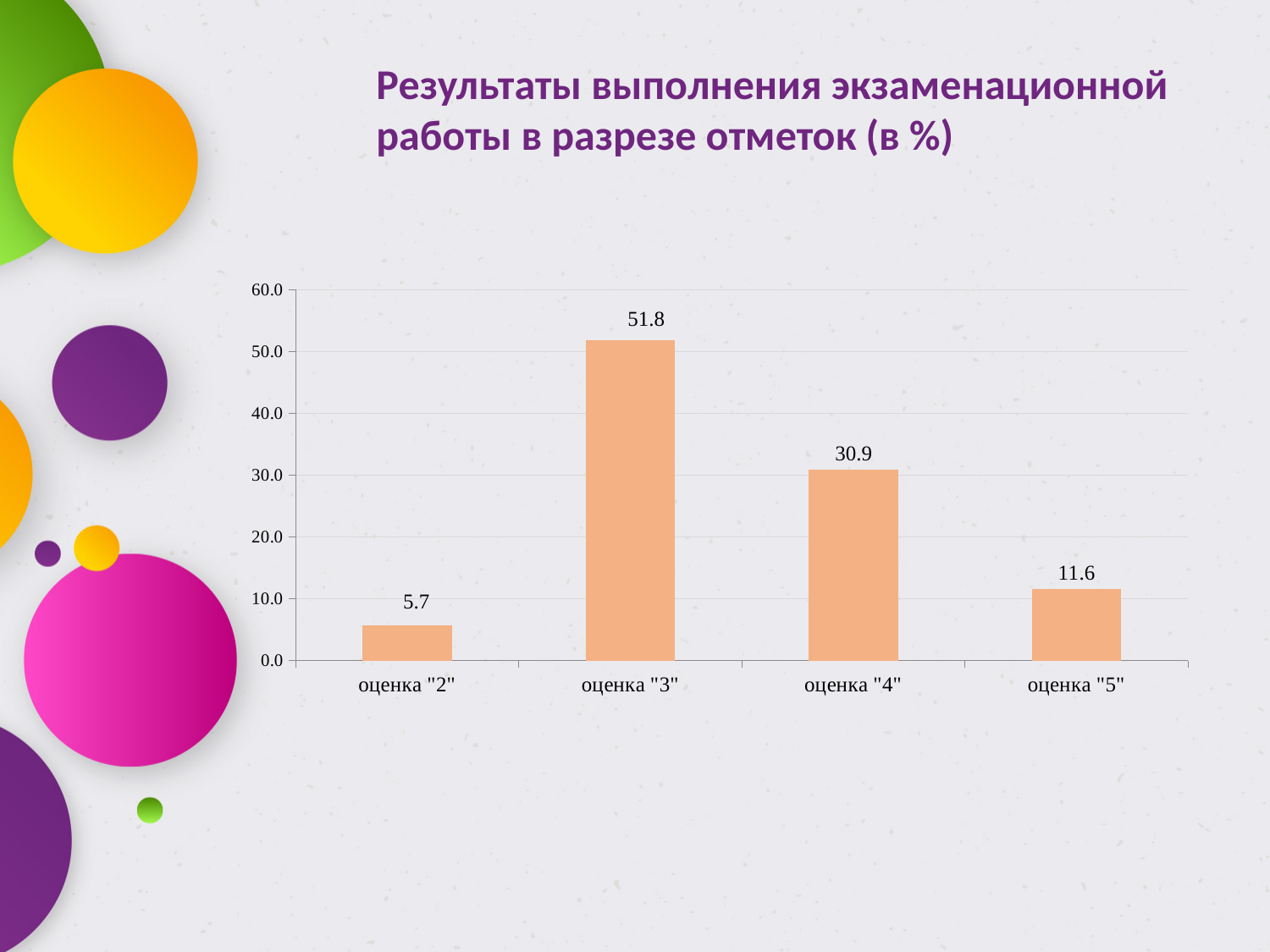
What kind of chart is shown on the slide? bar chart What is the difference between the values for оценка "3" and оценка "4"? 20.9 Which category has the highest value? оценка "3" Which is larger, the value for оценка "4" or the value for оценка "5"? оценка "4" What is the difference between the values for оценка "5" and оценка "2"? 5.9 What is the value for оценка "2"? 5.7 Is the value for оценка "4" greater or less than 30.0? greater What is the title of the slide? Результаты выполнения экзаменационной работы в разрезе отметок (в %) Which category has the lowest value? оценка "2" How many categories are shown on the x axis? 4 What is the value for оценка "3"? 51.8 What is the value for оценка "5"? 11.6